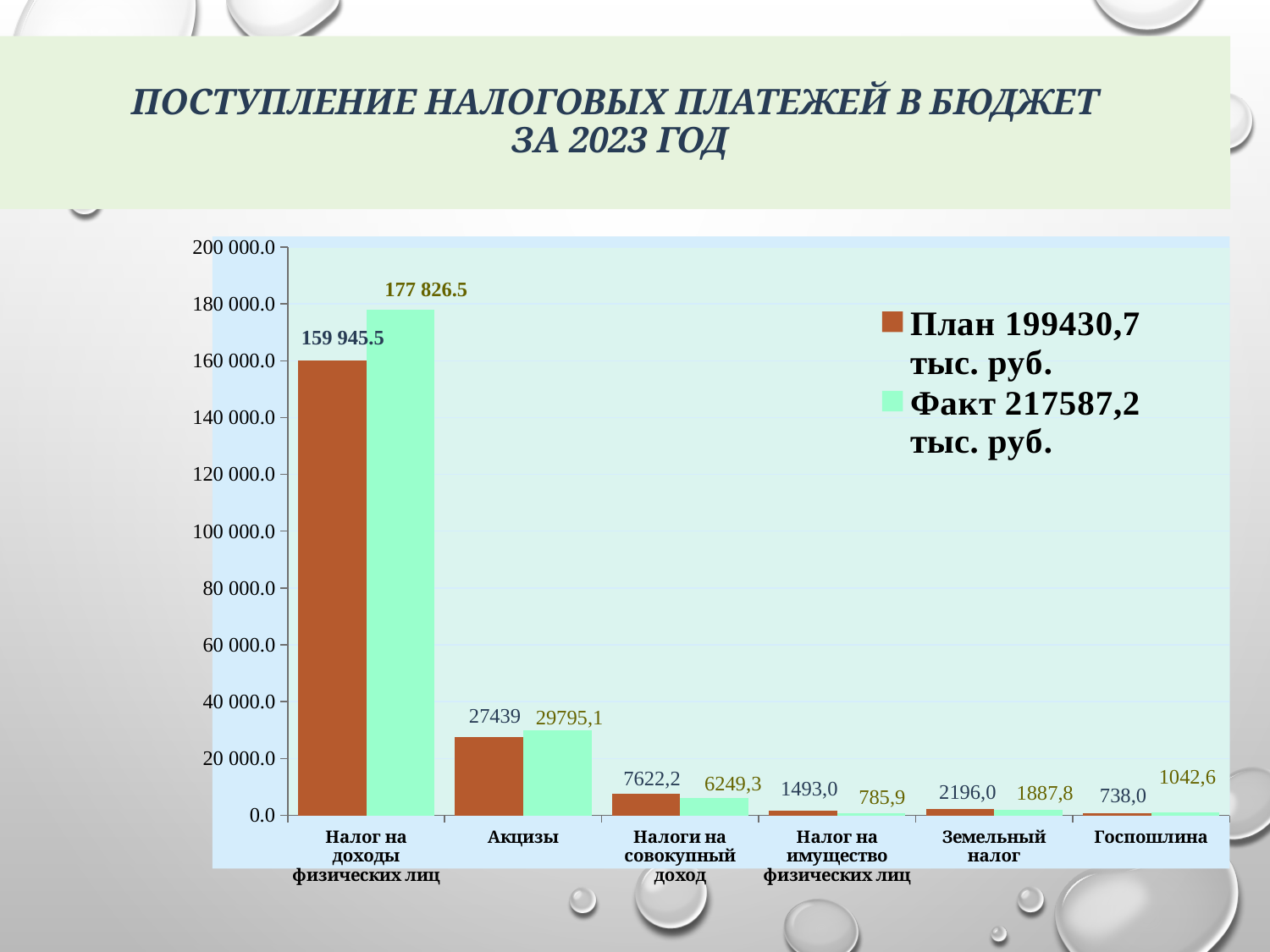
What is the Факт value for Госпошлина? 1042,6 What is the difference between the Факт and План values for Налог на доходы физических лиц? 17 881.0 What is the Факт value for Налог на доходы физических лиц? 177 826.5 Which category has the highest Факт value? Налог на доходы физических лиц What is the План value for Акцизы? 27439 What kind of chart is shown on the slide? Bar chart For Налоги на совокупный доход, which is larger: the План value or the Факт value? План How many series does the legend list? 2 How many categories are shown on the x axis? 6 Which category has the lowest План value? Госпошлина What is the difference between the План and Факт values for Налог на имущество физических лиц? 707,1 What is the План value for Земельный налог? 2196,0